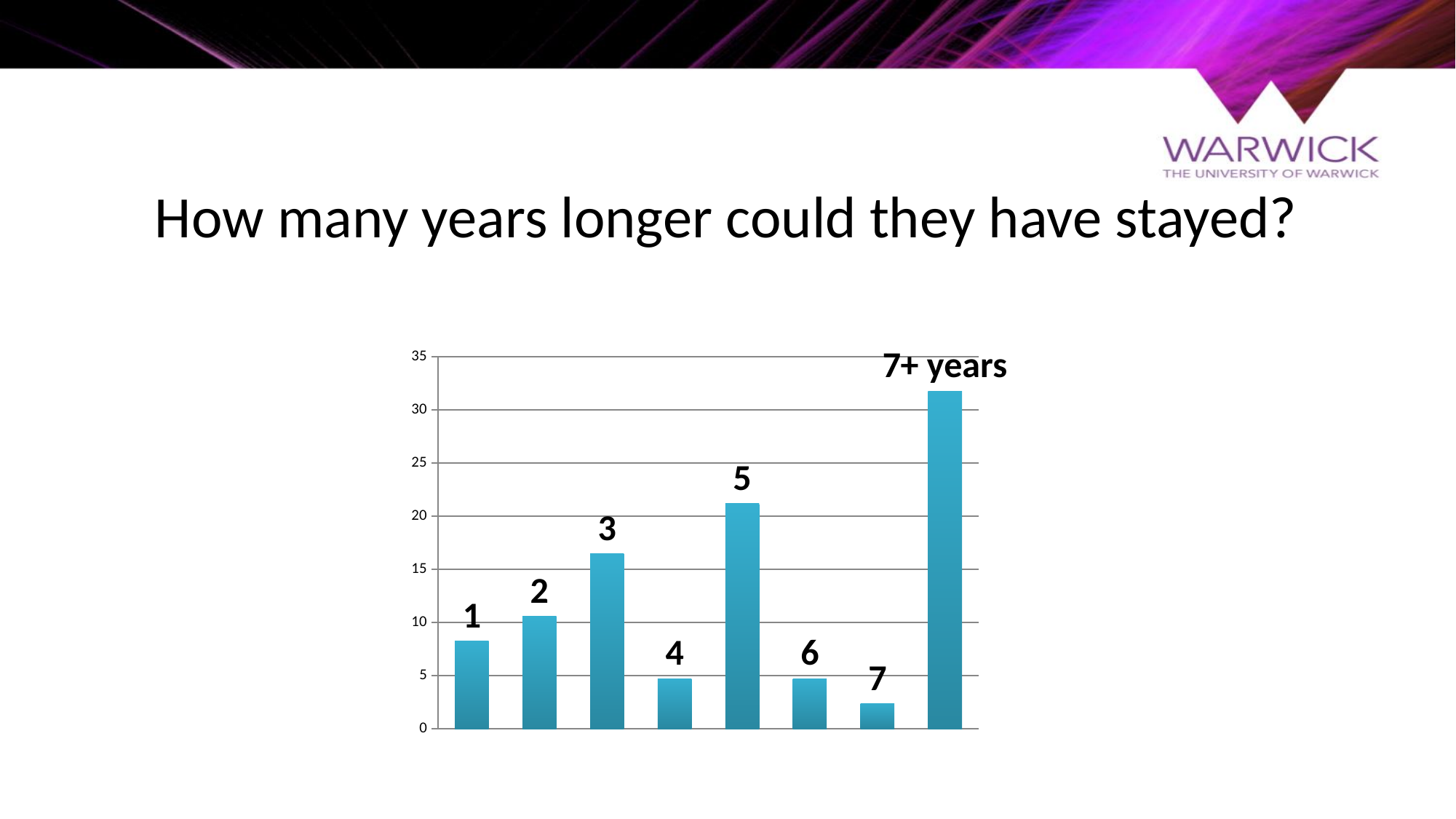
Is the value for the bar labelled 7 greater or less than 5? less What is the title of the slide above the chart? How many years longer could they have stayed? Which bar is taller, the one labelled 5 or the one labelled 3? 5 What kind of chart is shown on the slide? bar chart Which category has the shortest bar? 7 Is the value for the bar labelled 5 greater or less than 20? greater Which bar is taller, the one labelled 2 or the one labelled 7? 2 Is the value for the 7+ years bar greater or less than 30? greater Which category has the tallest bar? 7+ years How many bars are plotted in the chart? 8